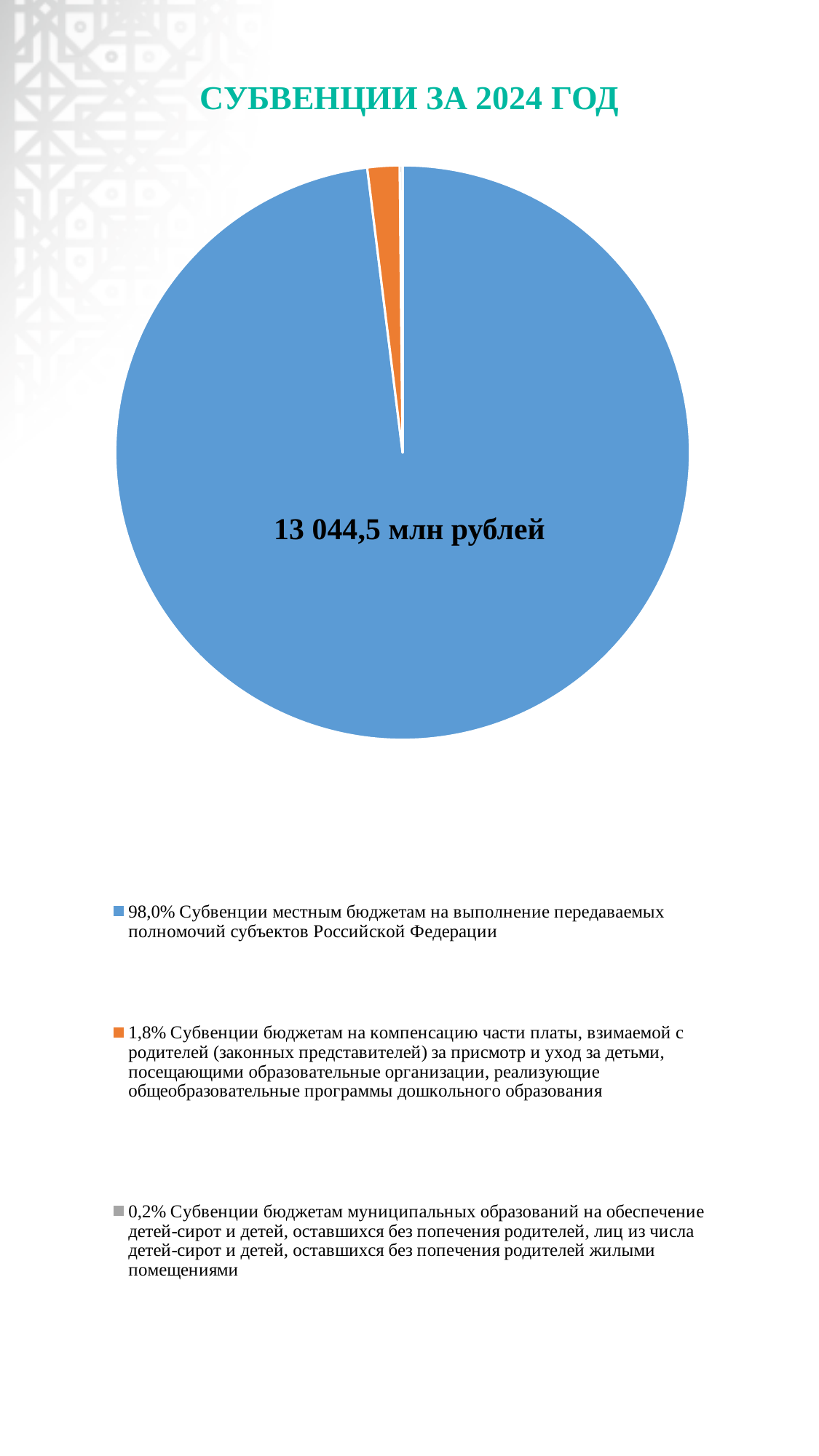
What is the difference in percentage points between the 98,0% slice and the 1,8% slice? 96,2% What is the title of the chart? СУБВЕНЦИИ ЗА 2024 ГОД What type of chart is shown on the slide titled «СУБВЕНЦИИ ЗА 2024 ГОД»? Pie chart How many categories does the legend of the pie chart list? 3 What colour is the slice for «Субвенции местным бюджетам на выполнение передаваемых полномочий субъектов Российской Федерации»? Blue Which is larger: the share for compensation of part of parental fees (1,8%) or the share for housing for orphans (0,2%)? Субвенции бюджетам на компенсацию части платы, взимаемой с родителей (1,8%) What share of the pie is «Субвенции местным бюджетам на выполнение передаваемых полномочий субъектов Российской Федерации»? 98,0% What total amount is printed in the centre of the pie chart? 13 044,5 млн рублей Which category has the largest share of the pie? Субвенции местным бюджетам на выполнение передаваемых полномочий субъектов Российской Федерации What share of the pie is «Субвенции бюджетам на компенсацию части платы, взимаемой с родителей (законных представителей) за присмотр и уход за детьми...»? 1,8% What share of the pie is «Субвенции бюджетам муниципальных образований на обеспечение детей-сирот и детей, оставшихся без попечения родителей... жилыми помещениями»? 0,2%